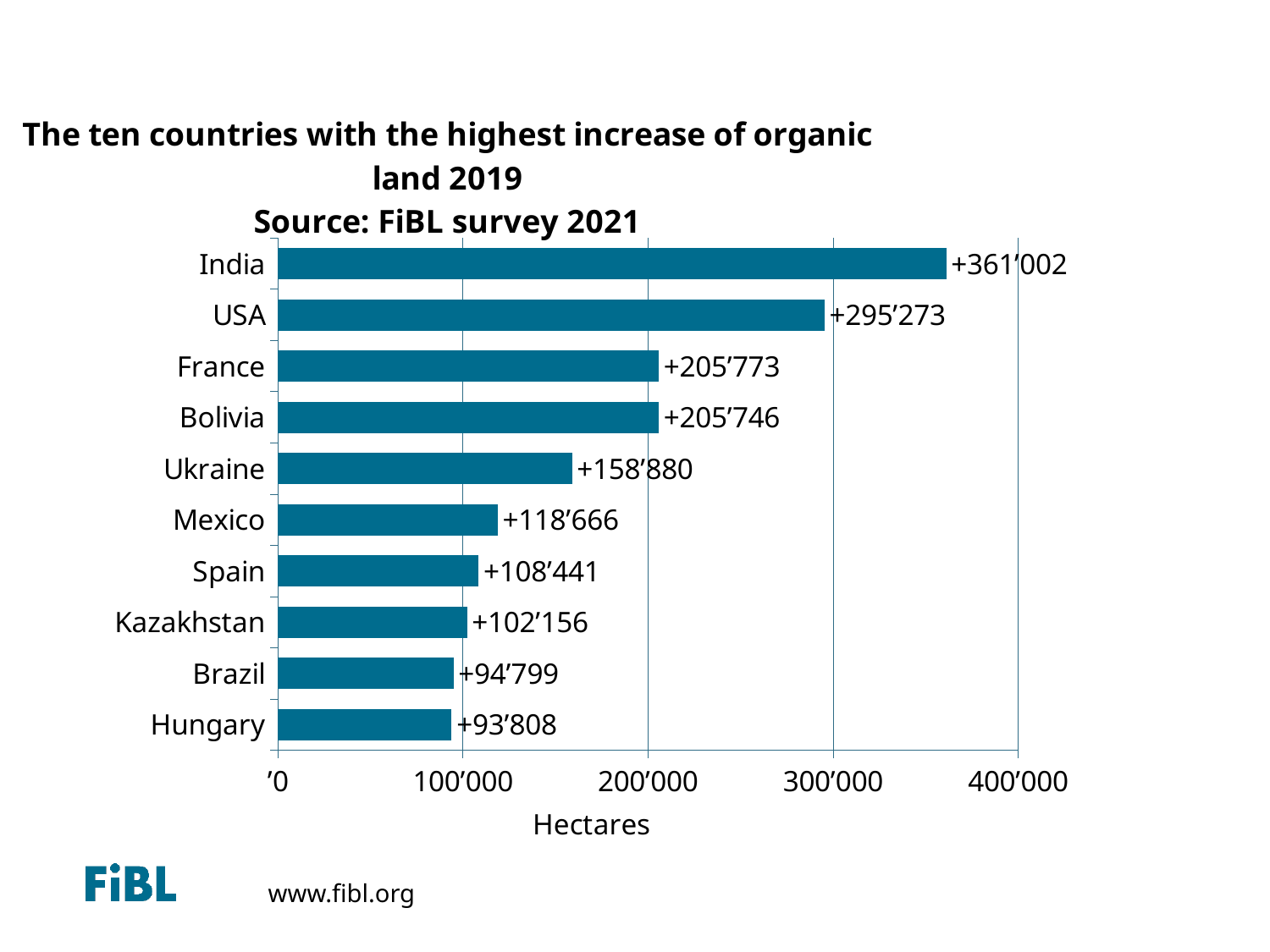
Is the value for Brazil greater or less than 100'000? less What is the increase of organic land for India? +361'002 What unit is shown on the horizontal axis of the chart? Hectares What is the increase of organic land for Ukraine? +158'880 Which country has the highest increase of organic land? India What kind of chart is shown on the slide? bar chart What is the difference between the increase for Mexico and the increase for Spain? 10'225 Which has a larger increase of organic land, Ukraine or Mexico? Ukraine What is the increase of organic land for Kazakhstan? +102'156 What is the difference between the increase for India and the increase for the USA? 65'729 How many countries are shown in the chart? 10 Which country has the lowest increase of organic land among the ten shown? Hungary